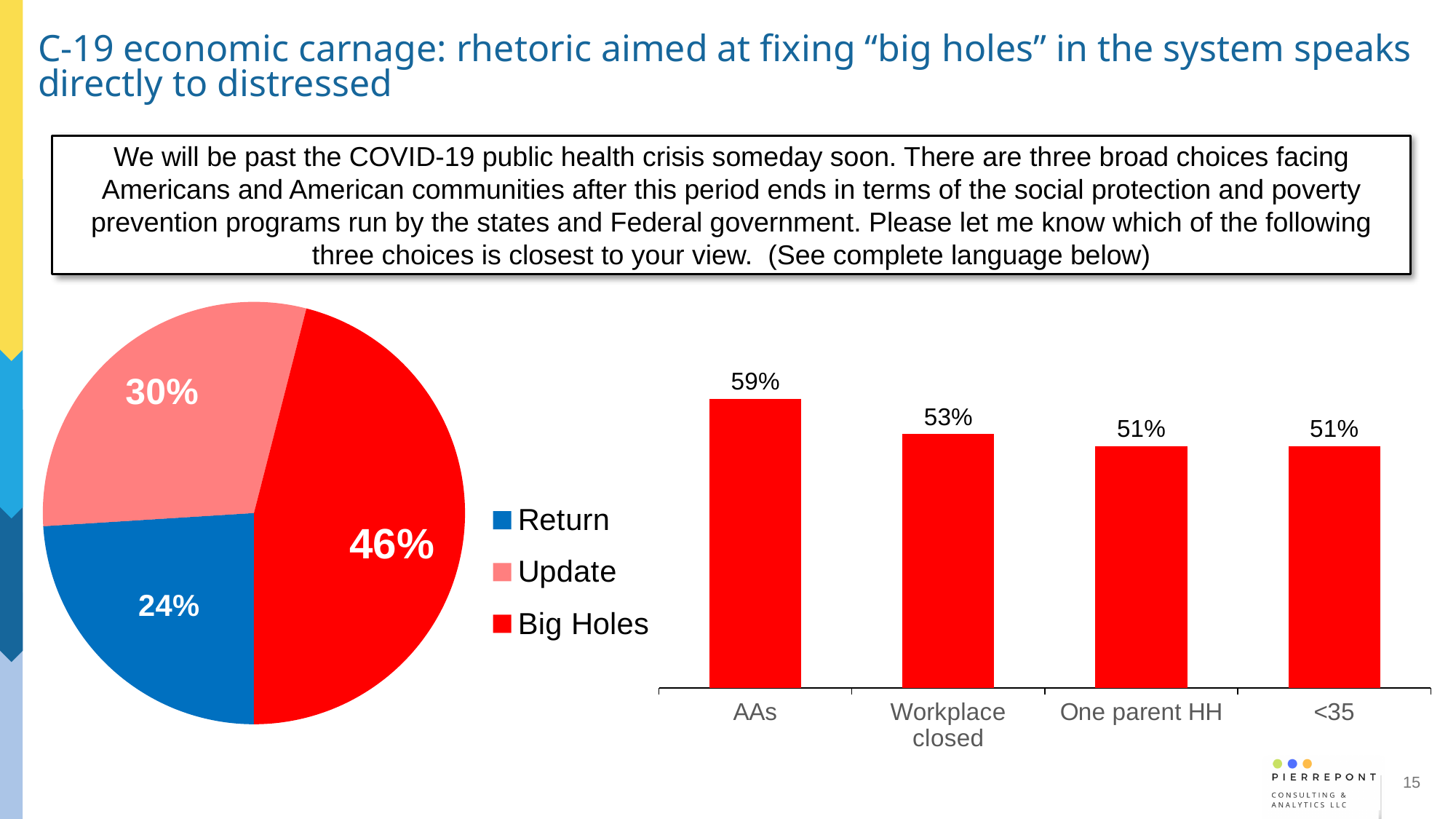
In the bar chart on the right, how many categories are shown? 4 In the bar chart on the right, what is the value for AAs? 59% In the pie chart on the left, how many entries does the legend list? 3 In the bar chart on the right, what is the difference between the values for AAs and Workplace closed? 6% In the pie chart on the left, which category has the largest slice? Big Holes What kind of chart is on the right side of the slide? Bar chart In the bar chart on the right, which category has the highest value? AAs In the pie chart on the left, what share is labelled for Big Holes? 46% In the pie chart on the left, which category has the smallest slice? Return In the bar chart on the right, what is the value for Workplace closed? 53% In the pie chart on the left, what share is labelled for Update? 30% In the pie chart on the left, what share is labelled for Return? 24%